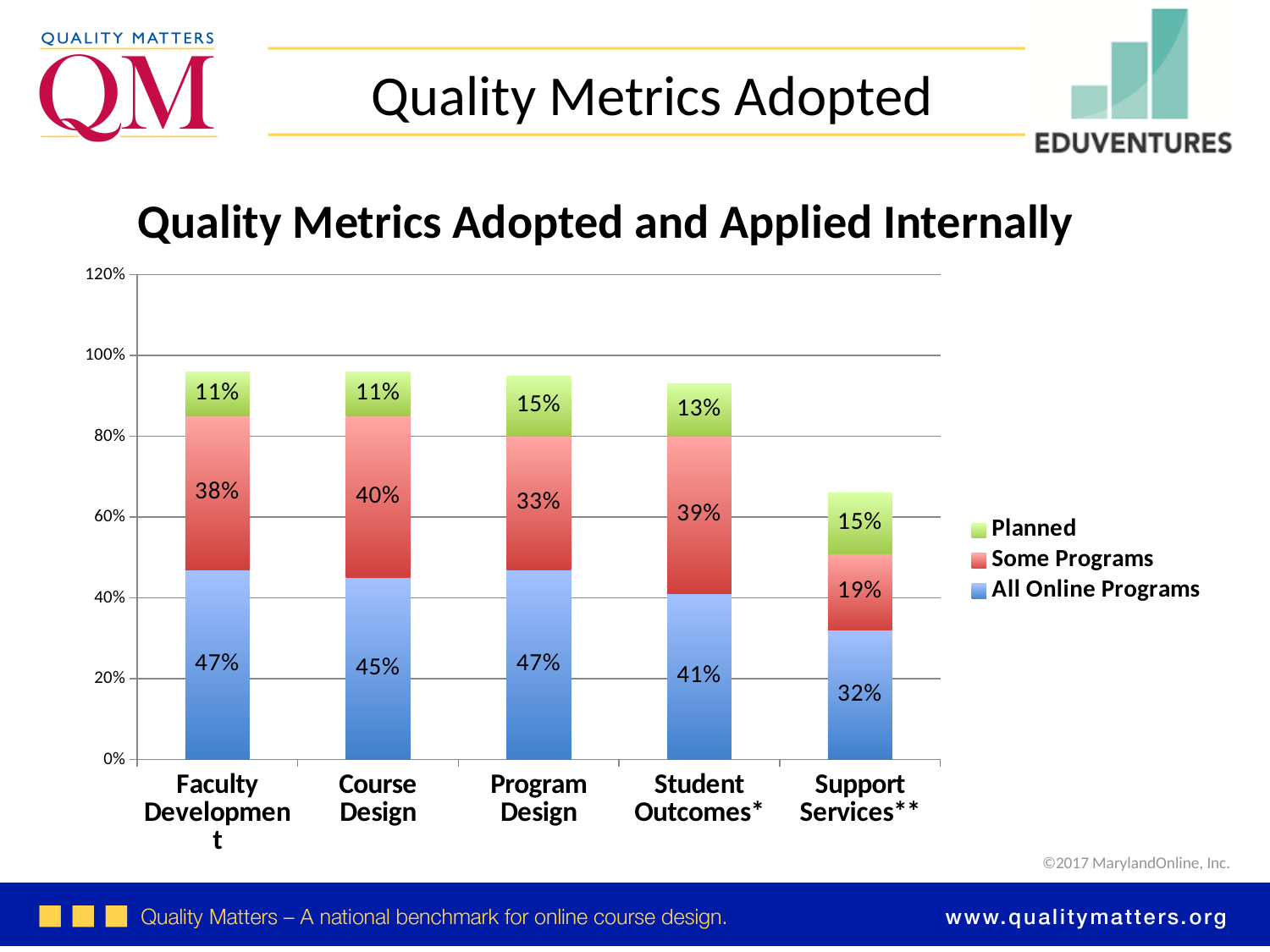
Which category has the highest Some Programs value? Course Design What kind of chart is shown on the slide? Stacked bar chart Which is larger, the All Online Programs value for Faculty Development or for Student Outcomes*? Faculty Development How many series does the legend list? 3 What is the difference between the Some Programs values for Course Design and Support Services**? 21% How many categories are shown on the x axis? 5 Which category has the lowest All Online Programs value? Support Services** Which series is shown in green in the legend? Planned What is the total of the stacked bar for Support Services**? 66% What is the Planned value for Program Design? 15% What is the All Online Programs value for Support Services**? 32% What is the Some Programs value for Course Design? 40%